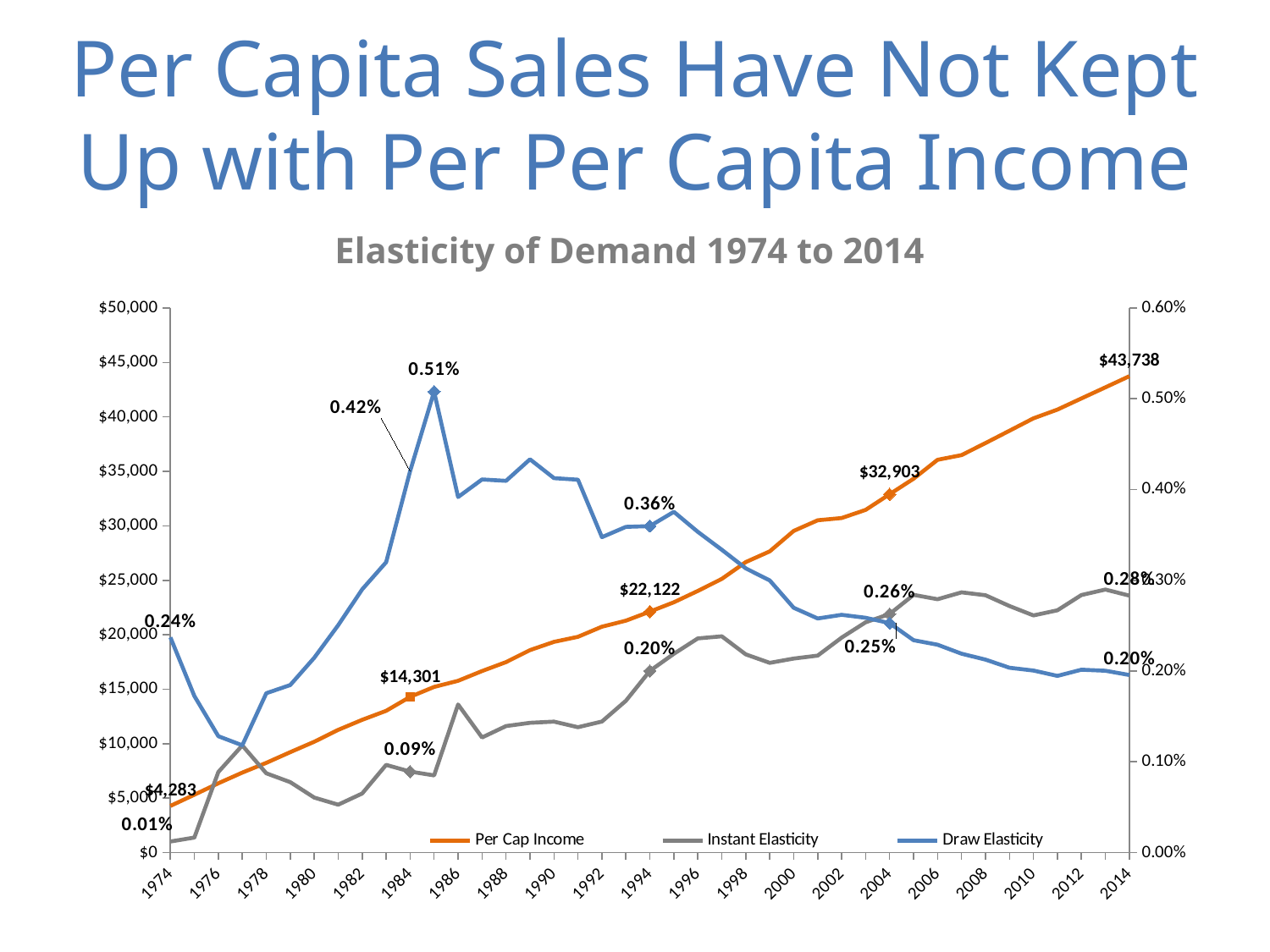
What is the difference between the Per Cap Income labels for 1994 and 1984? $7,821 Does the Per Cap Income series rise or fall from 1974 to 2014? rise What is the Per Cap Income value labeled for 1974? $4,283 What is the Per Cap Income value labeled for 2014? $43,738 What is the title of the chart? Elasticity of Demand 1974 to 2014 By how much did Per Cap Income increase from 2004 ($32,903) to 2014 ($43,738)? $10,835 What is the Instant Elasticity value labeled for 1974? 0.01% How many series does the chart legend list? 3 In 2014, which is larger: Instant Elasticity or Draw Elasticity? Instant Elasticity What is the Instant Elasticity value labeled for 2004? 0.26% What kind of chart is shown on the slide? line chart What is the highest labeled value of the Draw Elasticity series? 0.51%